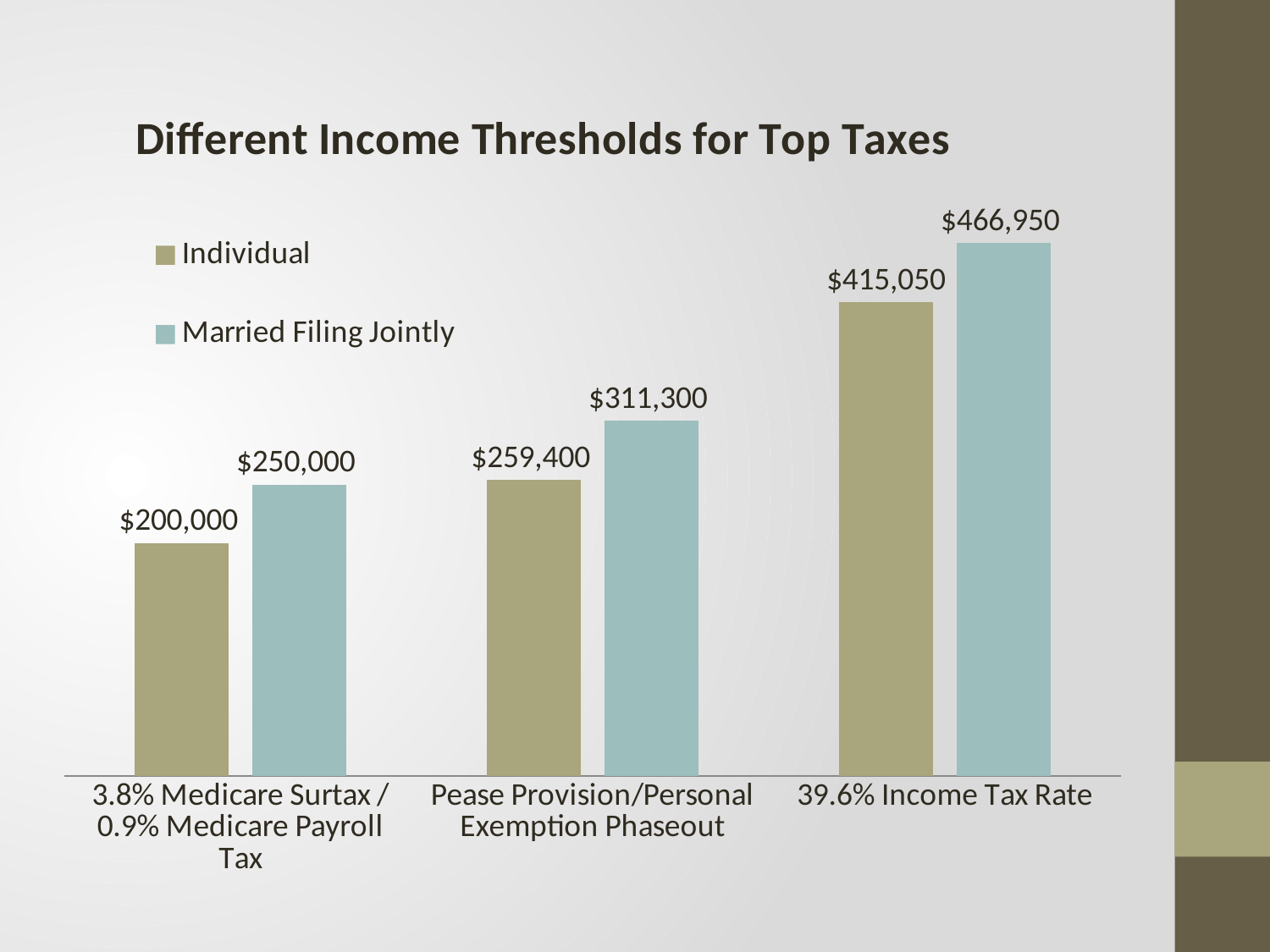
What kind of chart is shown on the slide? Bar chart What is the Married Filing Jointly threshold for the Pease Provision/Personal Exemption Phaseout? $311,300 Which is larger: the Individual threshold for the Pease Provision/Personal Exemption Phaseout or the Married Filing Jointly threshold for the 3.8% Medicare Surtax / 0.9% Medicare Payroll Tax? Individual threshold for the Pease Provision/Personal Exemption Phaseout What is the difference between the Married Filing Jointly and Individual thresholds for the 39.6% Income Tax Rate? $51,900 What is the Individual income threshold for the 39.6% Income Tax Rate? $415,050 Which category has the lowest Individual threshold? 3.8% Medicare Surtax / 0.9% Medicare Payroll Tax How many categories are shown on the x axis? 3 What is the difference between the Married Filing Jointly and Individual thresholds for the 3.8% Medicare Surtax / 0.9% Medicare Payroll Tax? $50,000 What is the title of the chart? Different Income Thresholds for Top Taxes Which category has the highest Married Filing Jointly threshold? 39.6% Income Tax Rate How many series does the legend list? 2 What is the Individual threshold for the 3.8% Medicare Surtax / 0.9% Medicare Payroll Tax? $200,000